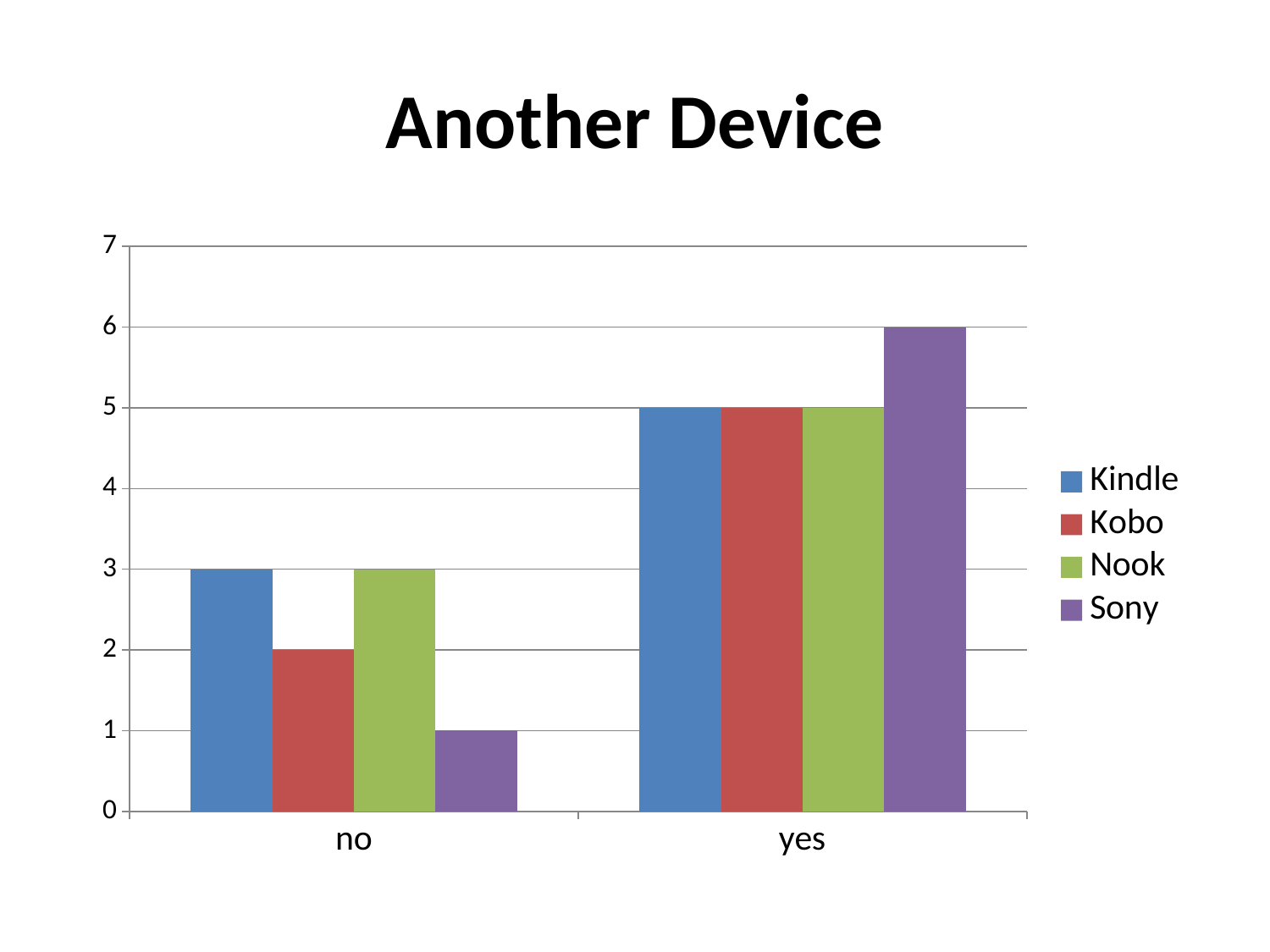
What is the difference between Sony's value for "yes" and Sony's value for "no"? 5 Which series has the highest value in the "yes" category? Sony What is the title of the slide? Another Device Which series has the lowest value in the "no" category? Sony Which is larger: Kindle's value for "no" or Kobo's value for "no"? Kindle What is the value for Kindle in the "no" category? 3 What is the value for Sony in the "yes" category? 6 How many categories are shown on the x axis? 2 What is the value for Kobo in the "no" category? 2 What kind of chart is shown on the slide? bar chart How many series does the legend list? 4 Is the value for Nook in the "yes" category greater or less than 4? greater